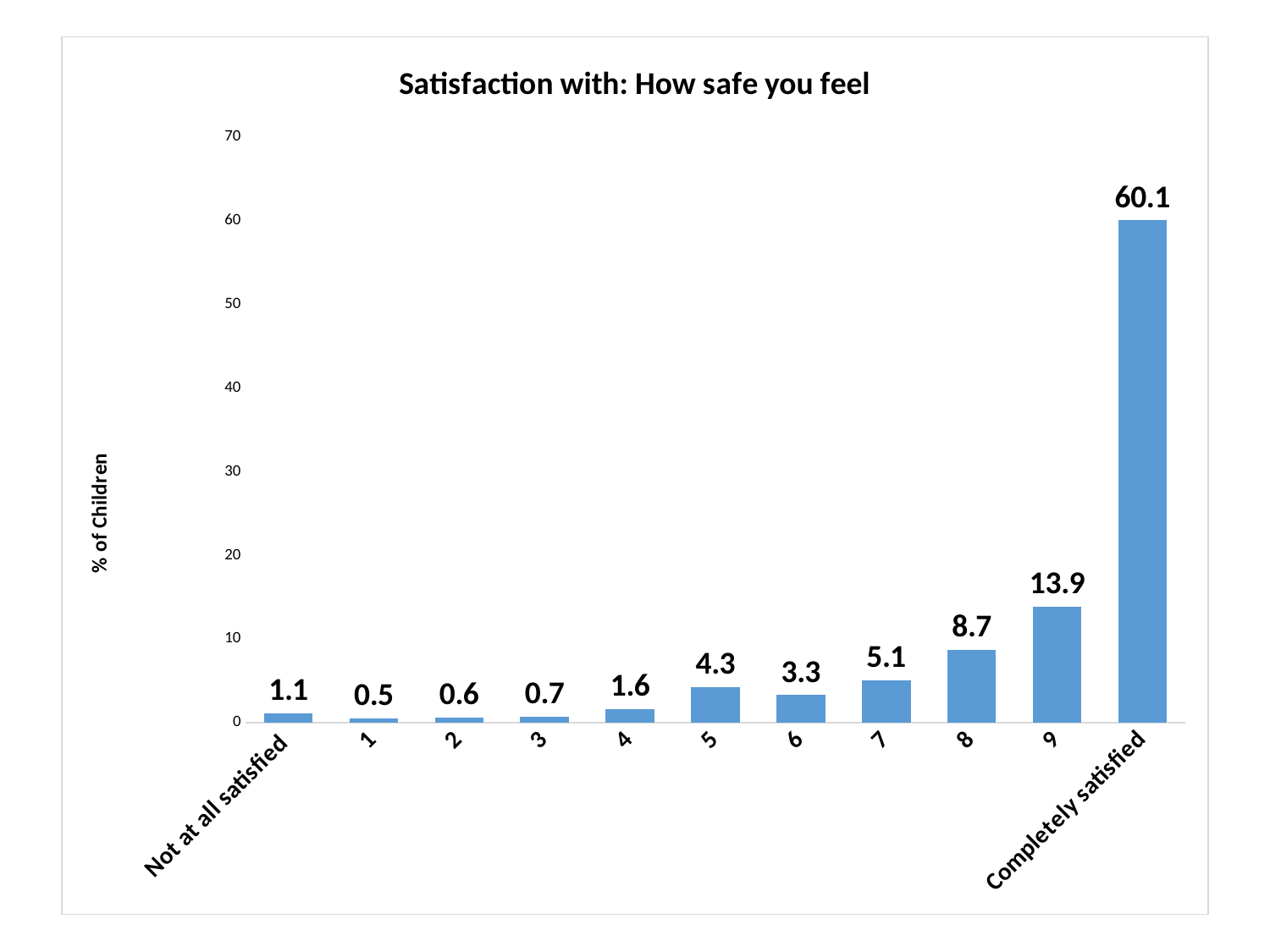
Is the value for "Completely satisfied" greater or less than 50? greater What is the difference between the values for "Completely satisfied" and category 9? 46.2 What is the title of the chart? Satisfaction with: How safe you feel How many categories are shown on the x axis? 11 What is the value for "Not at all satisfied"? 1.1 Which category has the lowest value? 1 What is the value for category 5? 4.3 Which is larger, the value for category 5 or category 6? 5 What is the value for "Completely satisfied"? 60.1 What kind of chart is this? bar chart Which category has the highest value? Completely satisfied What is the value for category 9? 13.9